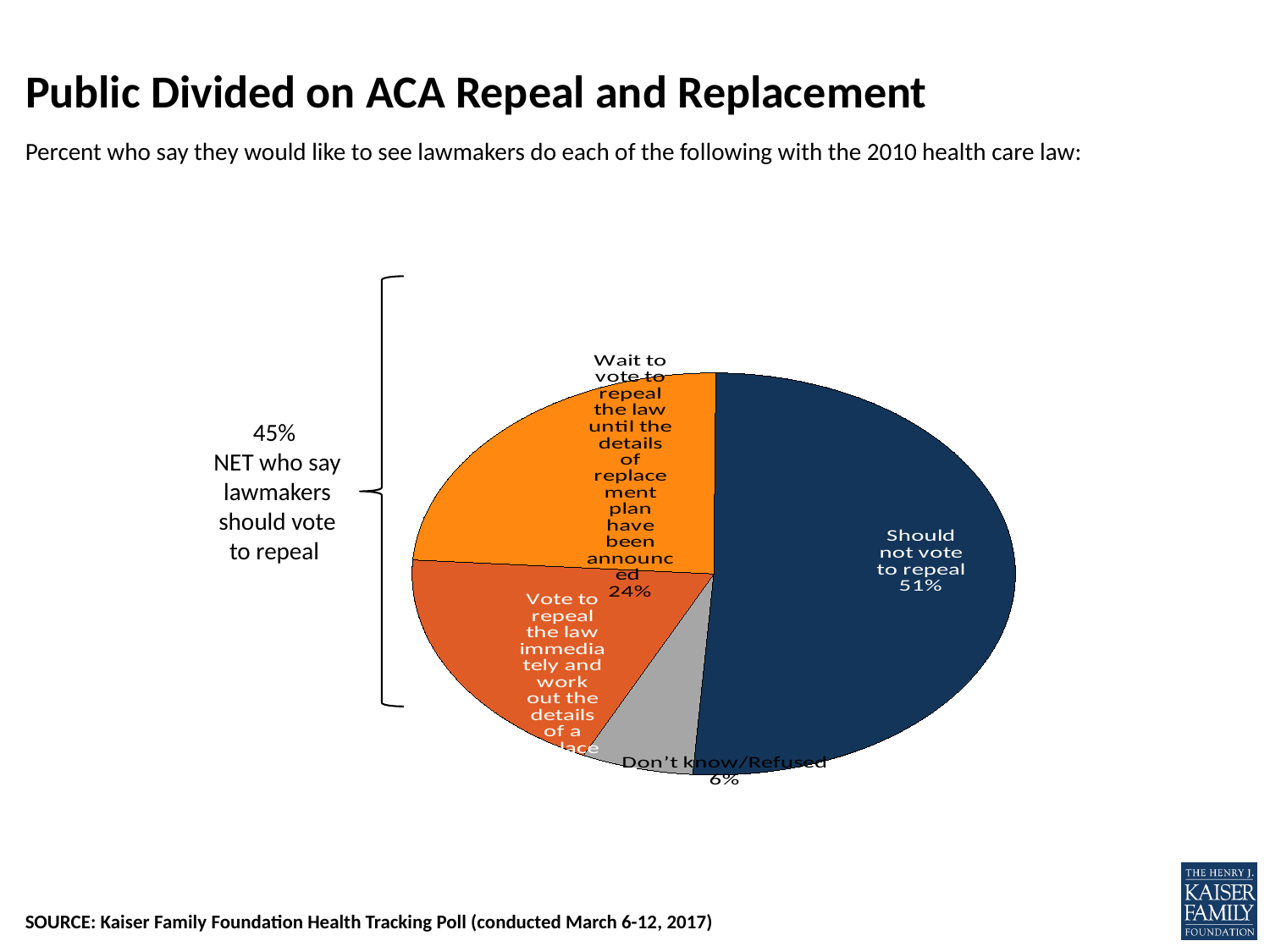
What percent answered Don't know/Refused? 6% Which is larger: the share who say lawmakers should not vote to repeal, or the share who say they should wait to vote to repeal until replacement details are announced? Should not vote to repeal What is the difference in percentage points between the 'Wait to vote to repeal' slice and the 'Don't know/Refused' slice? 18 percentage points What kind of chart is shown on the slide? Pie chart What percent say lawmakers should wait to vote to repeal the law until the details of a replacement plan have been announced? 24% According to the annotation beside the pie chart, what is the NET percent who say lawmakers should vote to repeal? 45% What percent say lawmakers should not vote to repeal the law? 51% What colour is the 'Should not vote to repeal' slice? Dark blue Which slice of the pie chart is the largest? Should not vote to repeal How many slices does the pie chart have? 4 Which slice of the pie chart is the smallest? Don't know/Refused How many percentage points larger is the 'Should not vote to repeal' slice than the 'Wait to vote to repeal' slice? 27 percentage points